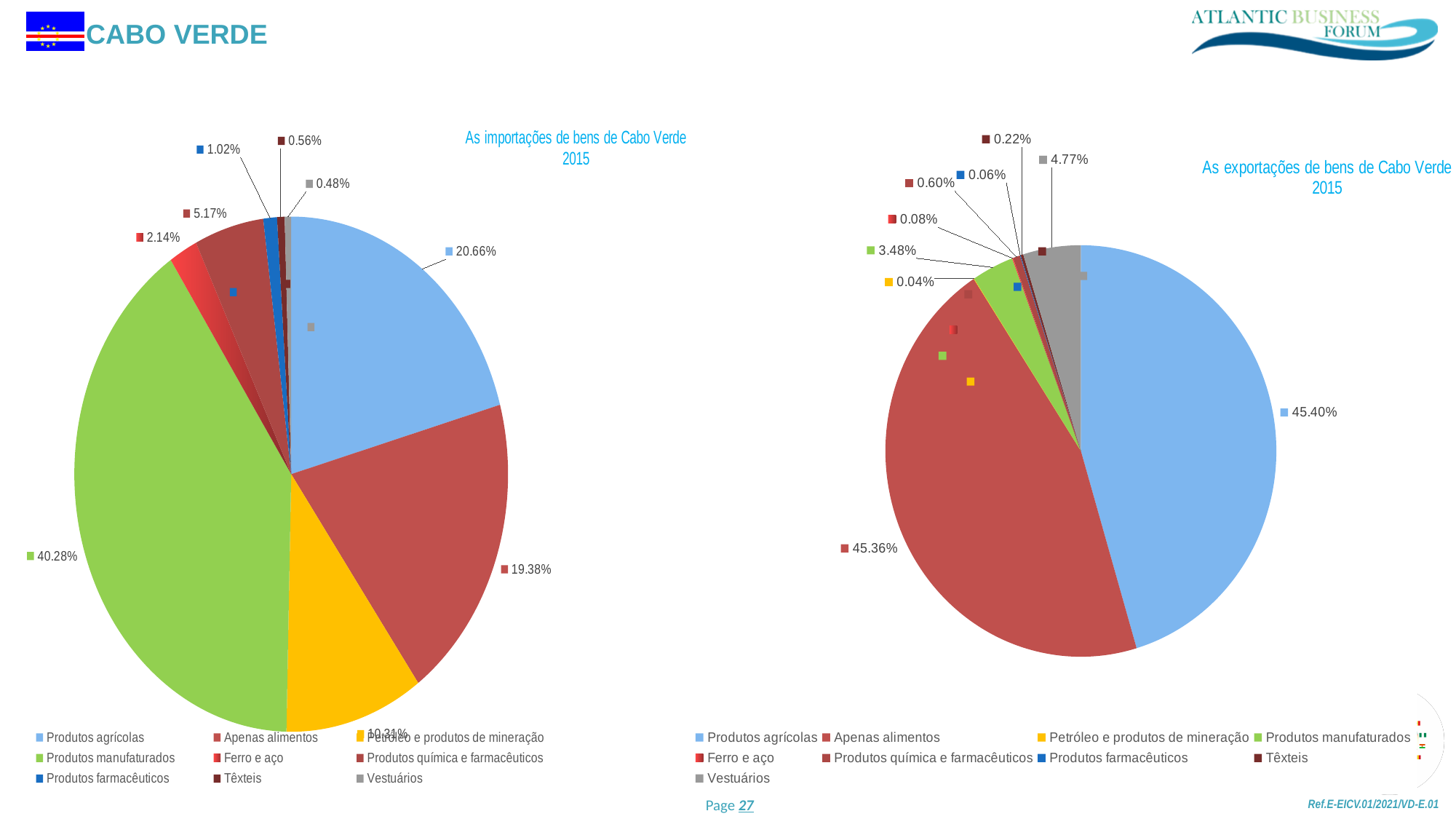
On the right chart (As exportações de bens de Cabo Verde 2015), what share do Produtos agrícolas have? 45.40% On the left chart (As importações de bens de Cabo Verde 2015), which category has the smallest slice? Vestuários What is the title of the right chart? As exportações de bens de Cabo Verde 2015 How many categories does the legend of the right chart (As exportações de bens de Cabo Verde 2015) list? 9 On the left chart (As importações de bens de Cabo Verde 2015), what share do Produtos manufaturados have? 40.28% On the right chart (As exportações de bens de Cabo Verde 2015), what share do Vestuários have? 4.77% On the left chart (As importações de bens de Cabo Verde 2015), what share do Produtos agrícolas have? 20.66% On the right chart (As exportações de bens de Cabo Verde 2015), which category has the smallest slice? Petróleo e produtos de mineração What type of chart is the left chart (As importações de bens de Cabo Verde 2015)? Pie chart On the left chart (As importações de bens de Cabo Verde 2015), which category has the largest slice? Produtos manufaturados On the right chart (As exportações de bens de Cabo Verde 2015), which is larger: Produtos manufaturados or Vestuários? Vestuários On the left chart (As importações de bens de Cabo Verde 2015), what is the difference between the shares of Produtos agrícolas and Apenas alimentos? 1.28%